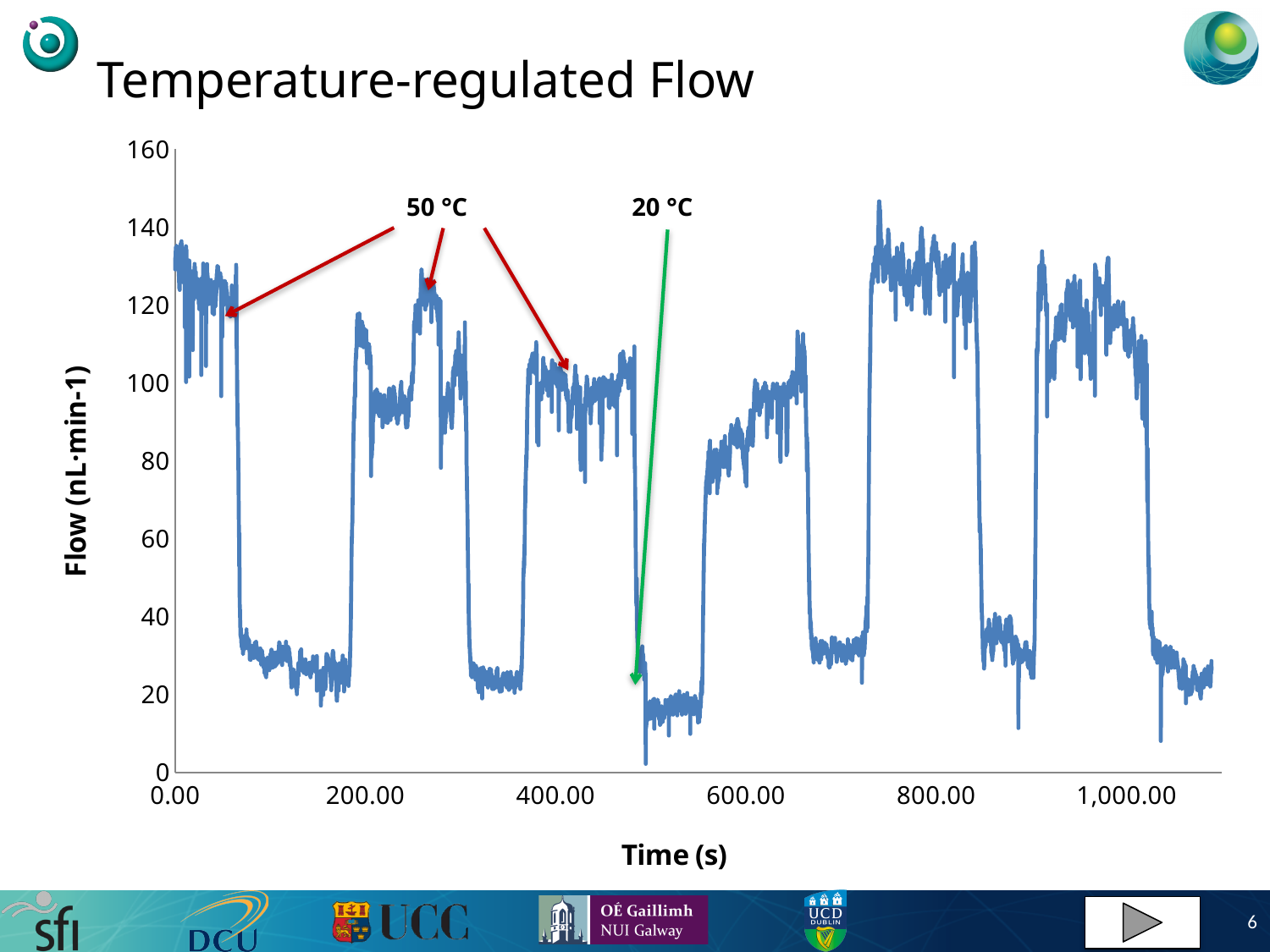
Is the flow value at around 100 s greater or less than 40? less How many data series are plotted on the chart? 1 Is the flow value at around 750 s greater or less than 120? greater Is the flow value at around 500 s greater or less than 40? less Is the flow at around 500 s larger or smaller than the flow at around 600 s? smaller What is the label of the y axis? Flow (nL·min-1) What kind of chart is shown on the slide? line chart What is the title of the chart? Temperature-regulated Flow